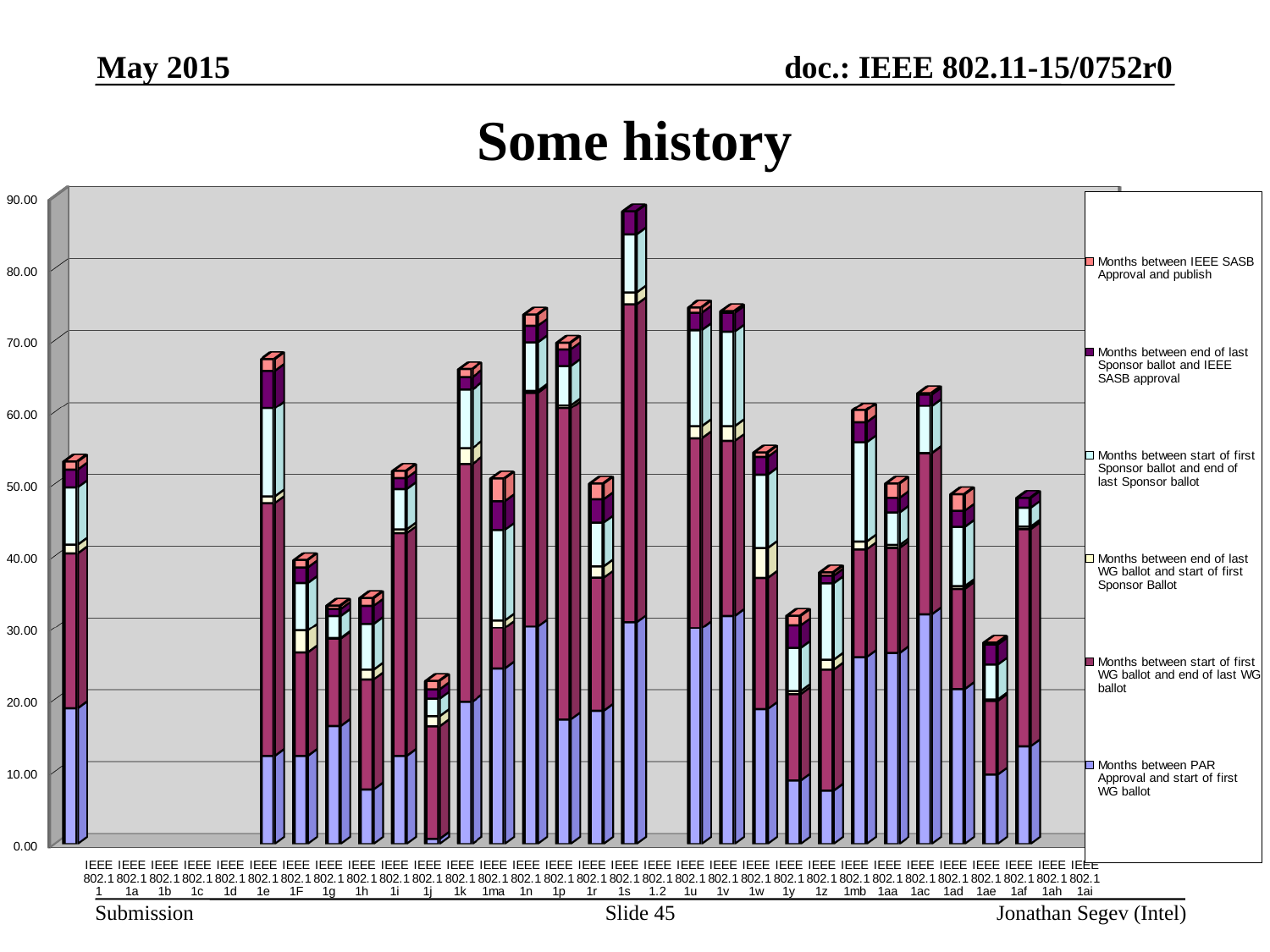
Is the total for IEEE 802.11e greater or less than 60? greater Which has the taller stacked bar, IEEE 802.11e or IEEE 802.11F? IEEE 802.11e Which has the taller stacked bar, IEEE 802.11s or IEEE 802.11n? IEEE 802.11s Is the total for IEEE 802.11ae greater or less than 30? less How many series does the legend list? 6 Is the total for IEEE 802.11j greater or less than 30? less What is the title of the slide's chart? Some history What kind of chart is shown on the slide? Stacked bar chart Which amendment has the tallest stacked bar? IEEE 802.11s Which legend entry corresponds to the bottom segment of each bar? Months between PAR Approval and start of first WG ballot How many categories are labelled along the x axis? 31